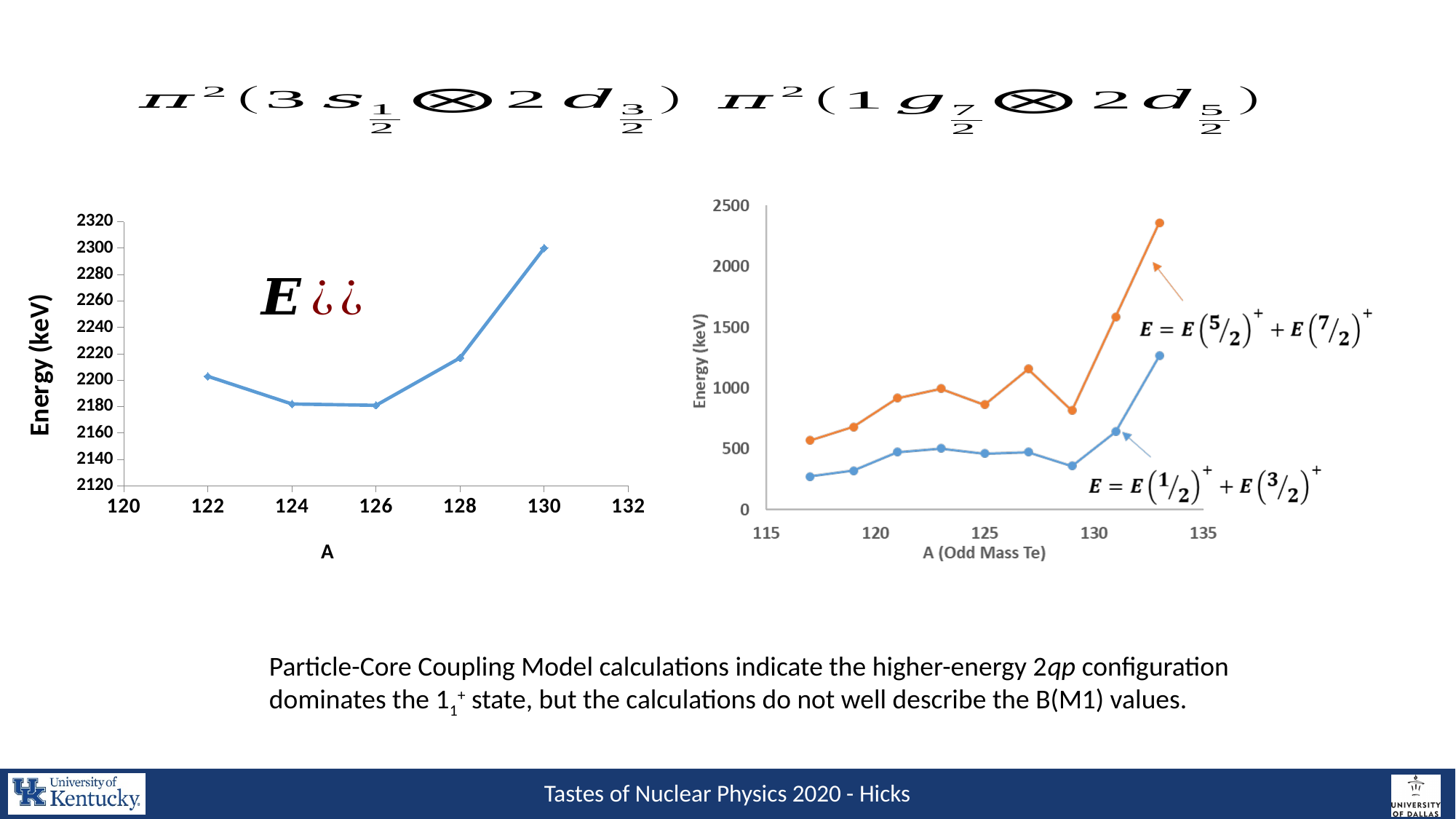
In the right chart (Energy (keV) vs A (Odd Mass Te)), how many data points does the orange series have? 9 In the left chart (Energy (keV) vs A), how many data points are plotted? 5 In the right chart (Energy (keV) vs A (Odd Mass Te)), is the orange series value at A = 133 greater or less than 2000? greater In the right chart (Energy (keV) vs A (Odd Mass Te)), at A = 125, which series has the larger value, orange or blue? orange What kind of chart is the left chart (Energy (keV) vs A)? line chart In the left chart (Energy (keV) vs A), what is the label of the x axis? A In the right chart (Energy (keV) vs A (Odd Mass Te)), is the blue series value at A = 117 greater or less than 500? less In the left chart (Energy (keV) vs A), do the values rise or fall from A = 126 to A = 130? rise In the left chart (Energy (keV) vs A), is the value at A = 130 greater or less than 2280? greater In the left chart (Energy (keV) vs A), at which value of A is the energy highest? 130 In the right chart (Energy (keV) vs A (Odd Mass Te)), how many data series are plotted? 2